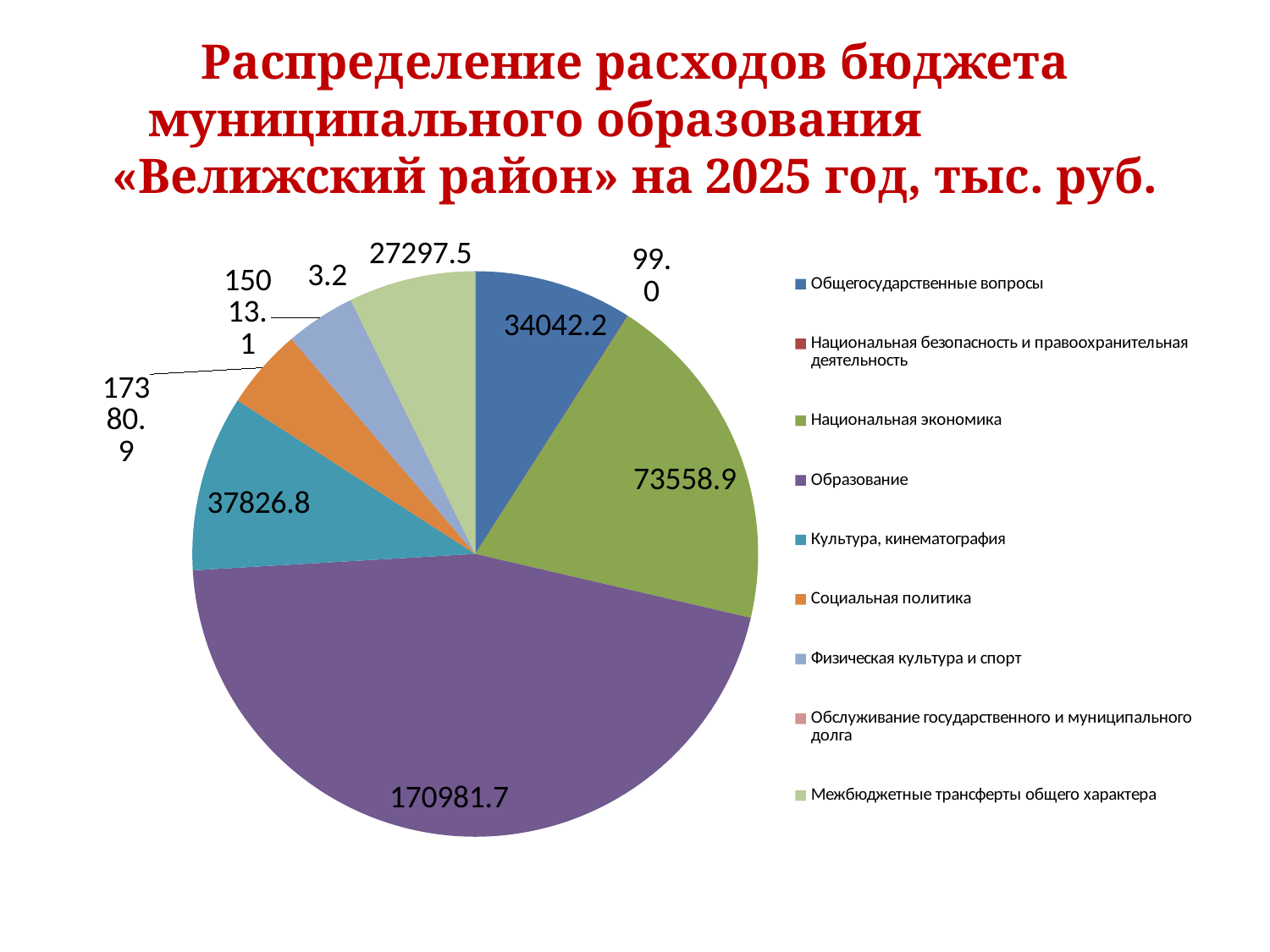
What is the value for Общегосударственные вопросы? 34042.2 What kind of chart is shown on the slide? pie chart What colour is the slice for Образование? purple What is the value for Образование? 170981.7 What is the difference between the values for Культура, кинематография and Общегосударственные вопросы? 3784.6 What is the value for Культура, кинематография? 37826.8 Which category has the smallest value in the pie chart? Обслуживание государственного и муниципального долга Which is larger, the value for Национальная экономика or the value for Культура, кинематография? Национальная экономика How many categories does the legend of the pie chart list? 9 What is the value for Межбюджетные трансферты общего характера? 27297.5 What is the value for Национальная экономика? 73558.9 Which category has the largest slice of the pie? Образование